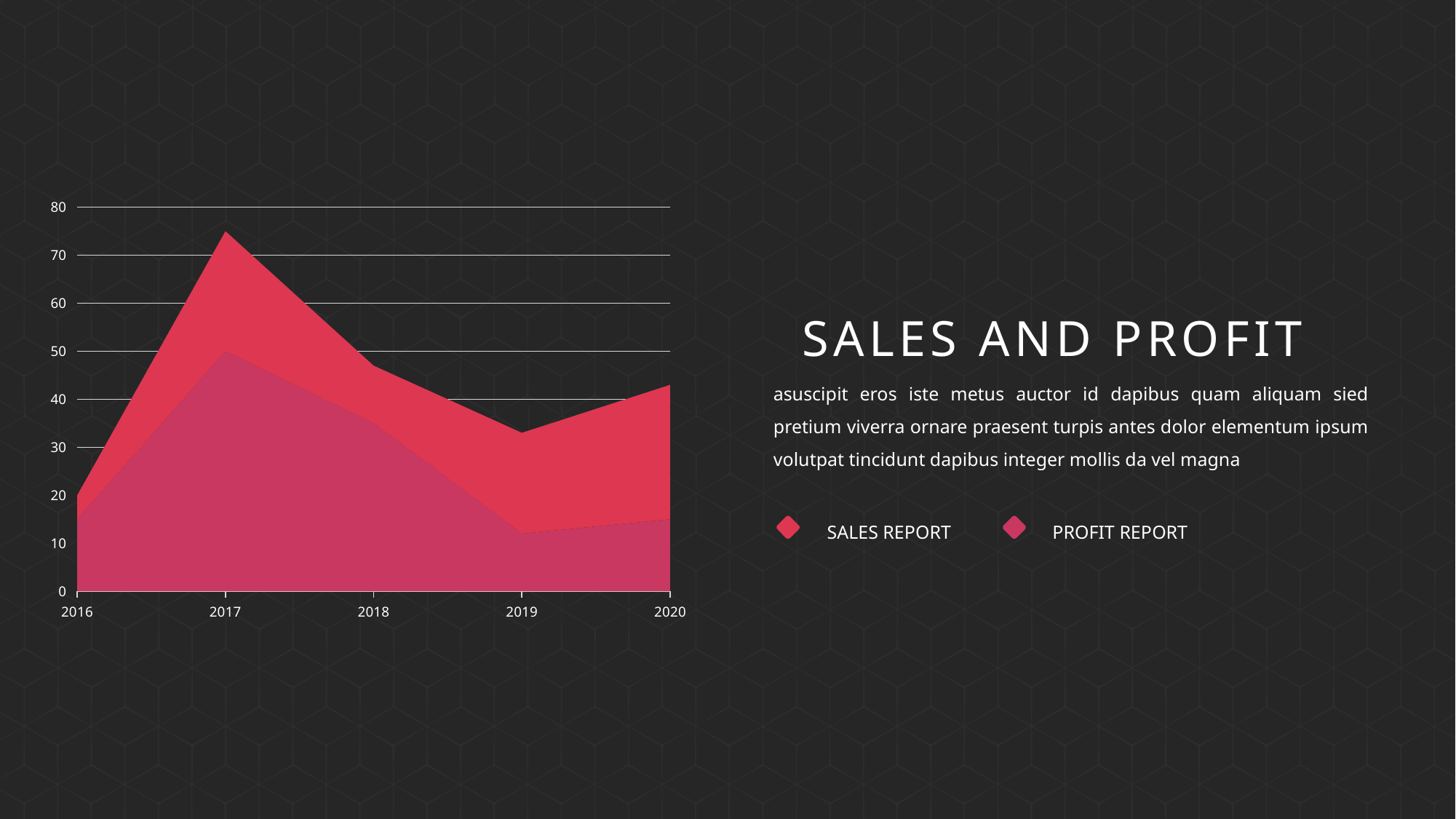
What are the two legend entries on the slide? SALES REPORT and PROFIT REPORT Does the Sales Report value rise or fall from 2017 to 2019? fall Is the Sales Report value for 2017 greater or less than 70? less In which year is the Profit Report value highest? 2017 How many series does the legend list? 2 What kind of chart is shown on the slide? area chart In which year is the Sales Report value lowest? 2016 Is the Profit Report value for 2019 greater or less than 20? less How many years are plotted along the x axis? 5 Is the Profit Report value for 2017 greater or less than 40? greater Which year has the larger Sales Report value, 2018 or 2019? 2019 In which year is the Sales Report value highest? 2020